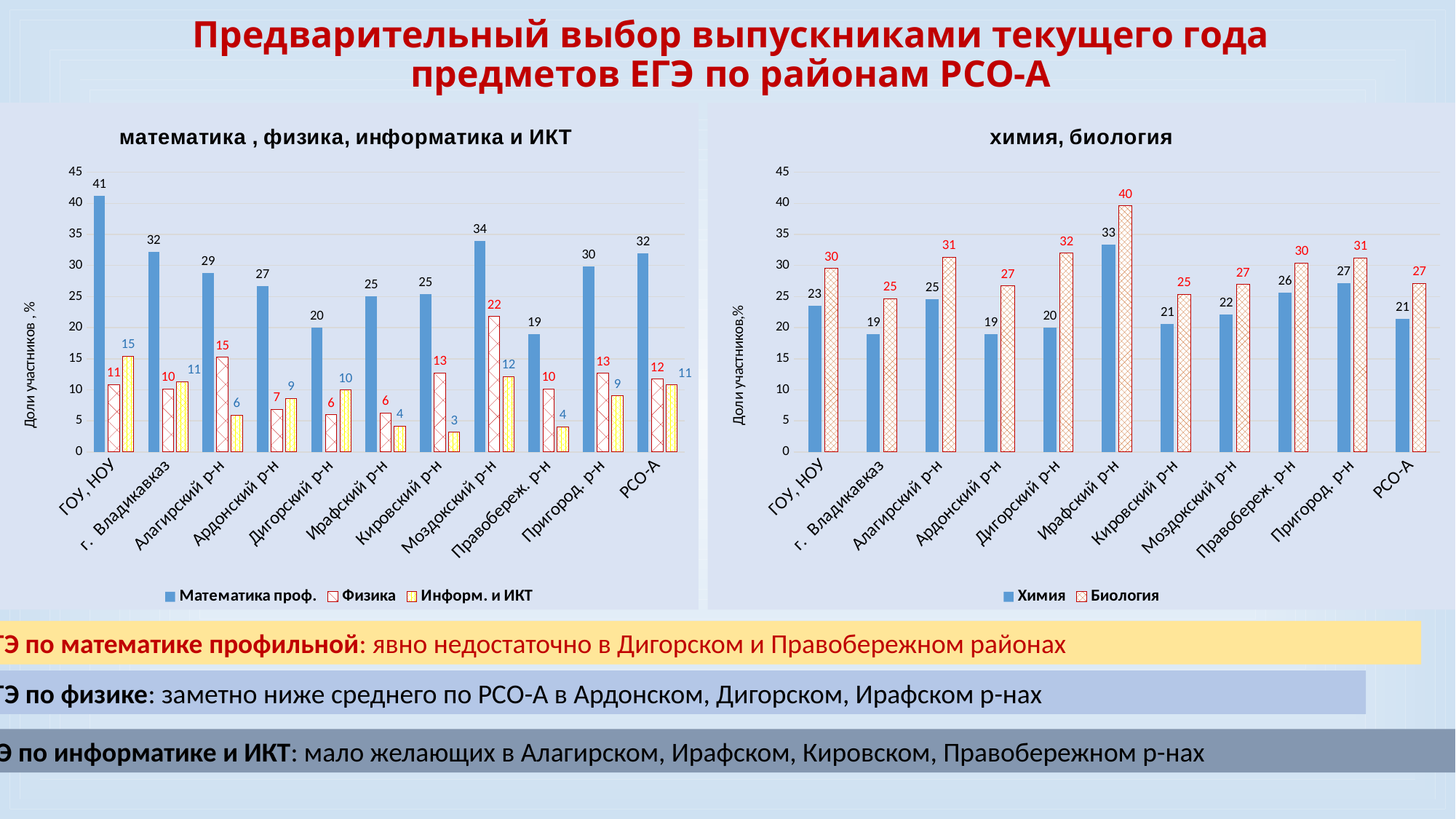
In the chart titled "математика , физика, информатика и ИКТ", which category has the lowest value for Информ. и ИКТ? Кировский р-н In the chart titled "математика , физика, информатика и ИКТ", what is the value of Математика проф. for ГОУ, НОУ? 41 In the chart titled "химия, биология", which category has the highest value for Химия? Ирафский р-н In the chart titled "математика , физика, информатика и ИКТ", what is the difference between the Математика проф. values for Моздокский р-н and Правобереж. р-н? 15 In the chart titled "химия, биология", what is the value of Биология for Ирафский р-н? 40 In the chart titled "химия, биология", which is larger for Дигорский р-н: Химия or Биология? Биология In the chart titled "математика , физика, информатика и ИКТ", what is the value of Физика for Моздокский р-н? 22 What type of chart is the chart titled "химия, биология"? Bar chart In the chart titled "химия, биология", how many categories are shown on the x axis? 11 In the chart titled "химия, биология", what is the difference between the Биология and Химия values for РСО-А? 6 In the chart titled "математика , физика, информатика и ИКТ", which category has the highest value for Математика проф.? ГОУ, НОУ In the chart titled "математика , физика, информатика и ИКТ", how many series does the legend list? 3